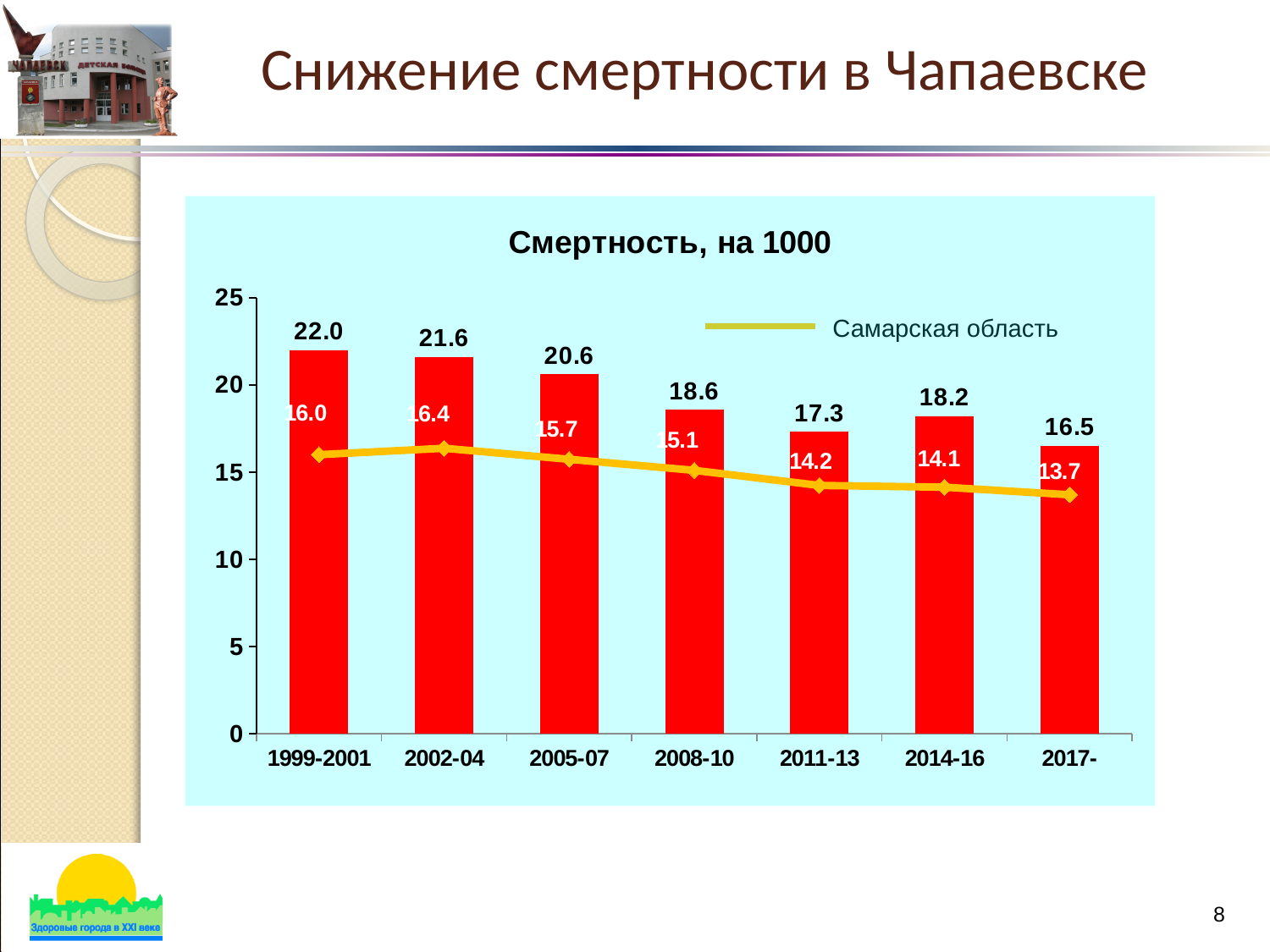
Which period has the highest red bar? 1999-2001 What is the difference between the red bar and the Самарская область line value for 1999-2001? 6.0 Which is larger: the red bar for 2011-13 or the red bar for 2014-16? 2014-16 What is the value of the red bar for 2008-10? 18.6 What is the value of the Самарская область line for 2011-13? 14.2 Which period has the lowest value on the Самарская область line? 2017- What kind of chart is this? Combined bar and line chart Is the red bar for 2005-07 greater or less than 20? greater Do the values of the Самарская область line generally rise or fall from 2002-04 to 2017-? fall What is the title of the chart? Смертность, на 1000 How many periods are shown on the x axis? 7 What is the value of the red bar for 2017-? 16.5